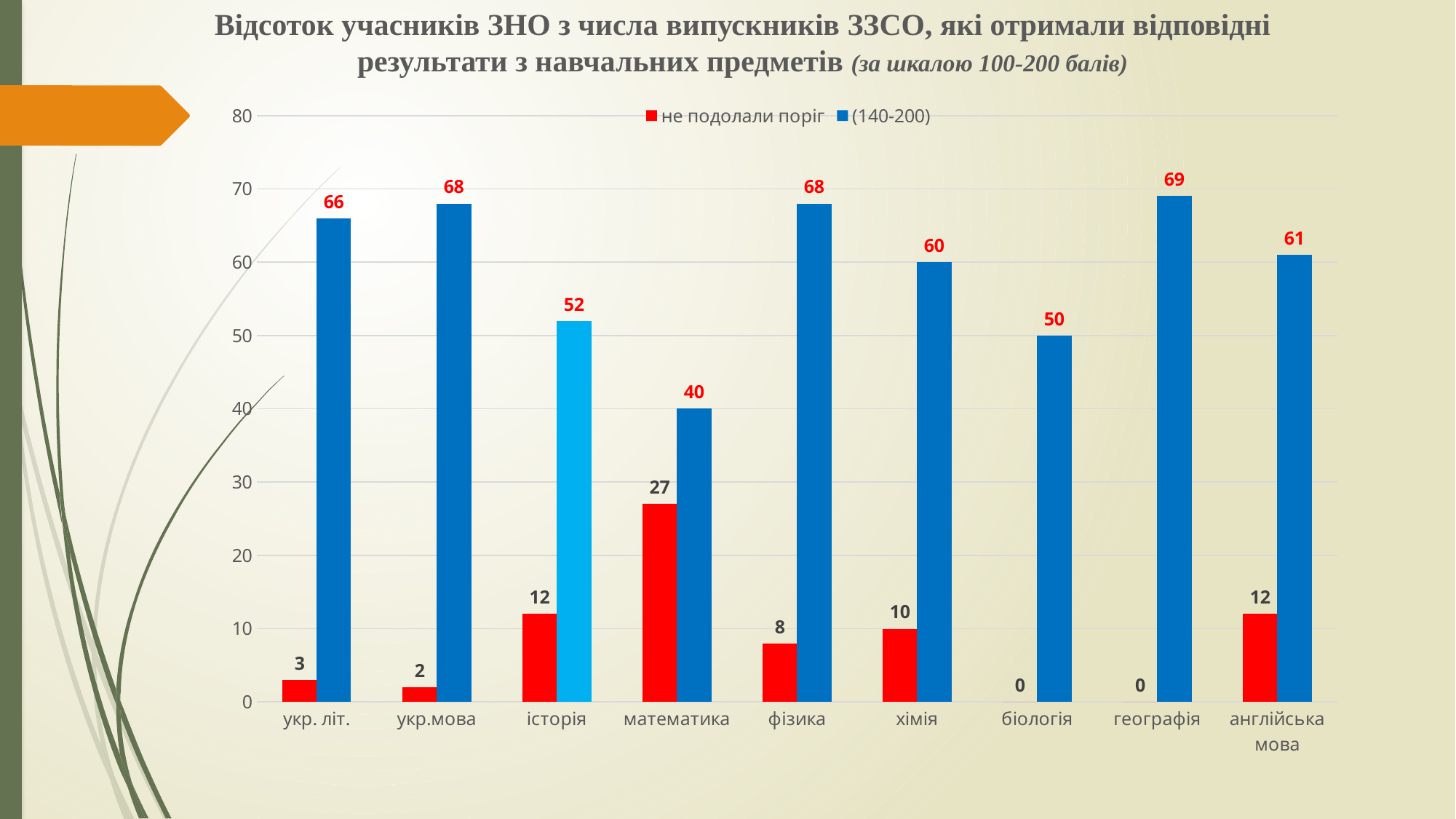
What is the value of the "(140-200)" series for математика? 40 How many series does the legend list? 2 What is the difference between the "(140-200)" values for укр.мова and історія? 16 Which categories have a value of 0 in the "не подолали поріг" series? біологія and географія How many categories are shown on the x axis? 9 What is the value of the "(140-200)" series for географія? 69 Which category has the highest value in the "не подолали поріг" series? математика What kind of chart is shown on the slide? bar chart Which category has the highest value in the "(140-200)" series? географія Which category has the lowest value in the "(140-200)" series? математика What is the value of the "не подолали поріг" series for хімія? 10 Which is larger: the "(140-200)" value for хімія or for англійська мова? англійська мова